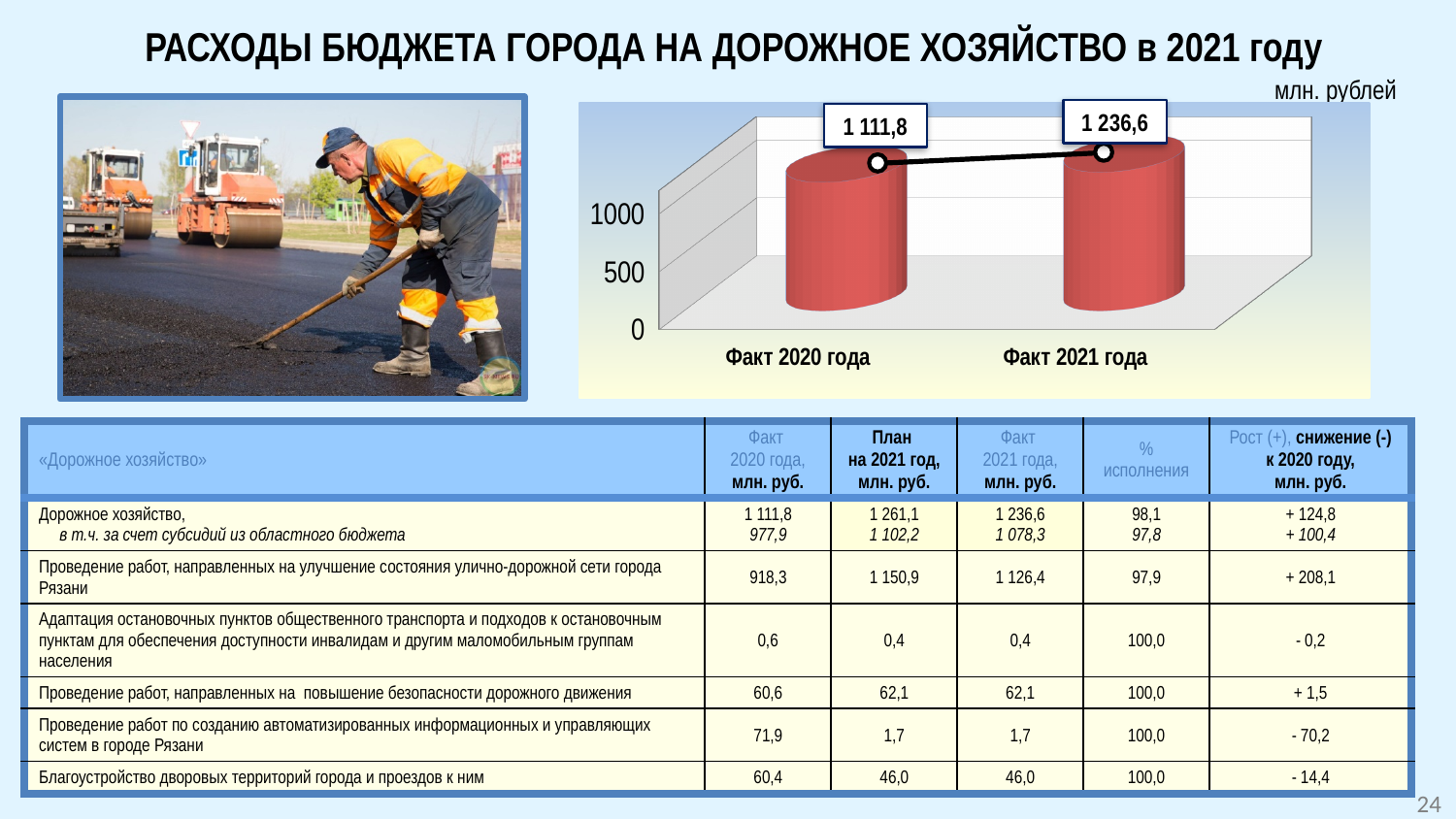
Is the value for Факт 2020 года larger or smaller than the value for Факт 2021 года? smaller Do the values rise or fall from Факт 2020 года to Факт 2021 года? rise Which category on the chart has the higher value? Факт 2021 года What is the value for Факт 2021 года on the chart? 1 236,6 Which category on the chart has the lower value? Факт 2020 года Is the value for Факт 2020 года greater or less than 1000? greater Is the value for Факт 2021 года greater or less than 500? greater What kind of chart is shown on the slide? bar chart What is the difference between the values for Факт 2021 года and Факт 2020 года on the chart? 124,8 How many categories are shown on the chart? 2 In what units are the chart values expressed, according to the label above the chart? млн. рублей What is the value for Факт 2020 года on the chart? 1 111,8